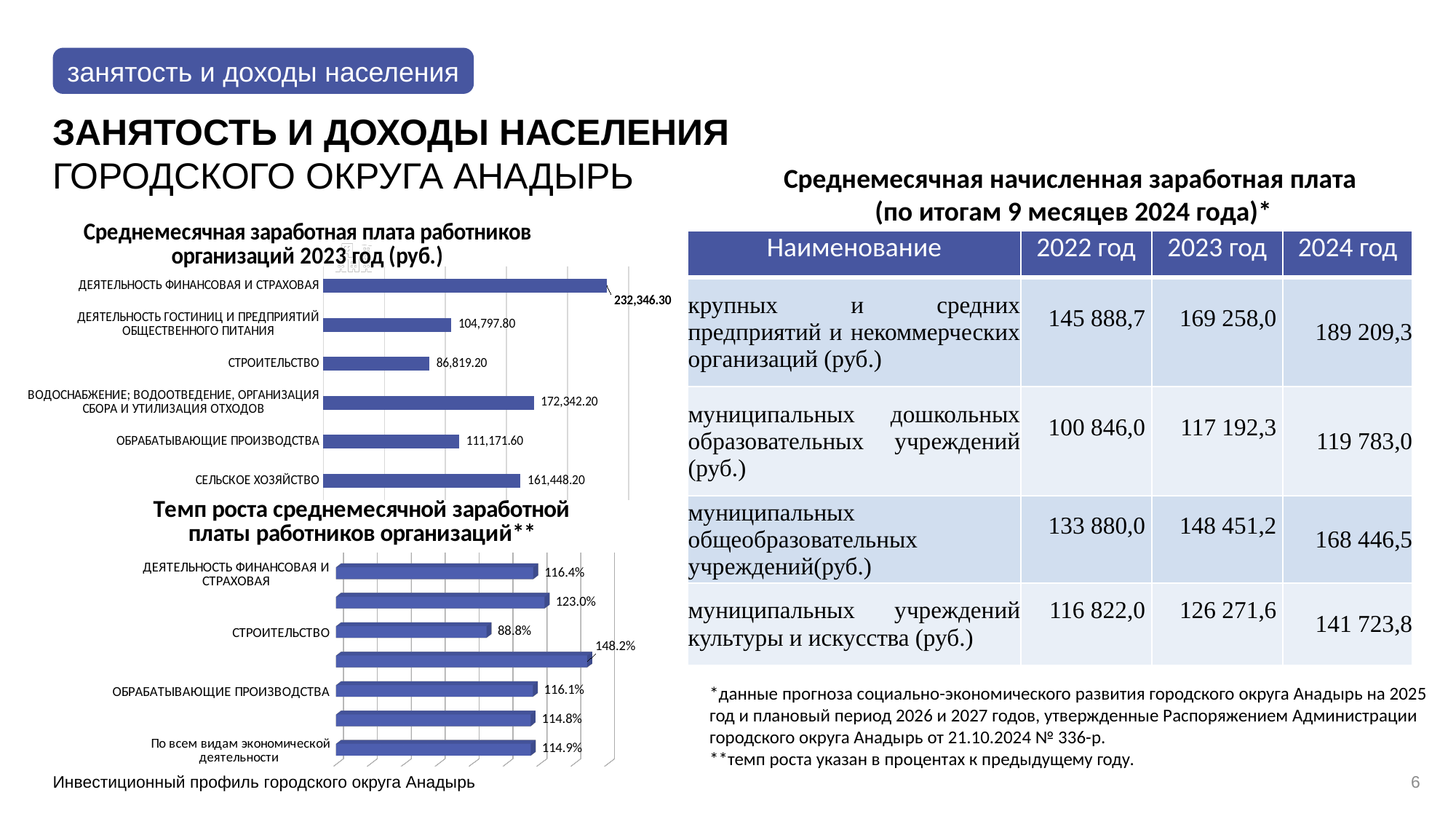
In the chart 'Среднемесячная заработная плата работников организаций 2023 год (руб.)', what is the value for СТРОИТЕЛЬСТВО? 86,819.20 In the chart 'Темп роста среднемесячной заработной платы работников организаций', what is the value for СТРОИТЕЛЬСТВО? 88.8% In the chart 'Среднемесячная заработная плата работников организаций 2023 год (руб.)', which category has the highest value? ДЕЯТЕЛЬНОСТЬ ФИНАНСОВАЯ И СТРАХОВАЯ In the chart 'Темп роста среднемесячной заработной платы работников организаций', which is larger: ДЕЯТЕЛЬНОСТЬ ФИНАНСОВАЯ И СТРАХОВАЯ or ОБРАБАТЫВАЮЩИЕ ПРОИЗВОДСТВА? ДЕЯТЕЛЬНОСТЬ ФИНАНСОВАЯ И СТРАХОВАЯ How many categories are shown in the chart 'Среднемесячная заработная плата работников организаций 2023 год (руб.)'? 6 In the chart 'Темп роста среднемесячной заработной платы работников организаций', what is the value for 'По всем видам экономической деятельности'? 114.9% What kind of chart is 'Среднемесячная заработная плата работников организаций 2023 год (руб.)'? Bar chart In the chart 'Среднемесячная заработная плата работников организаций 2023 год (руб.)', which is larger: ОБРАБАТЫВАЮЩИЕ ПРОИЗВОДСТВА or ДЕЯТЕЛЬНОСТЬ ГОСТИНИЦ И ПРЕДПРИЯТИЙ ОБЩЕСТВЕННОГО ПИТАНИЯ? ОБРАБАТЫВАЮЩИЕ ПРОИЗВОДСТВА How many bars are shown in the chart 'Темп роста среднемесячной заработной платы работников организаций'? 7 In the chart 'Среднемесячная заработная плата работников организаций 2023 год (руб.)', which category has the lowest value? СТРОИТЕЛЬСТВО In the chart 'Среднемесячная заработная плата работников организаций 2023 год (руб.)', what is the value for СЕЛЬСКОЕ ХОЗЯЙСТВО? 161,448.20 In the chart 'Среднемесячная заработная плата работников организаций 2023 год (руб.)', what is the difference between ДЕЯТЕЛЬНОСТЬ ФИНАНСОВАЯ И СТРАХОВАЯ and СТРОИТЕЛЬСТВО? 145,527.10